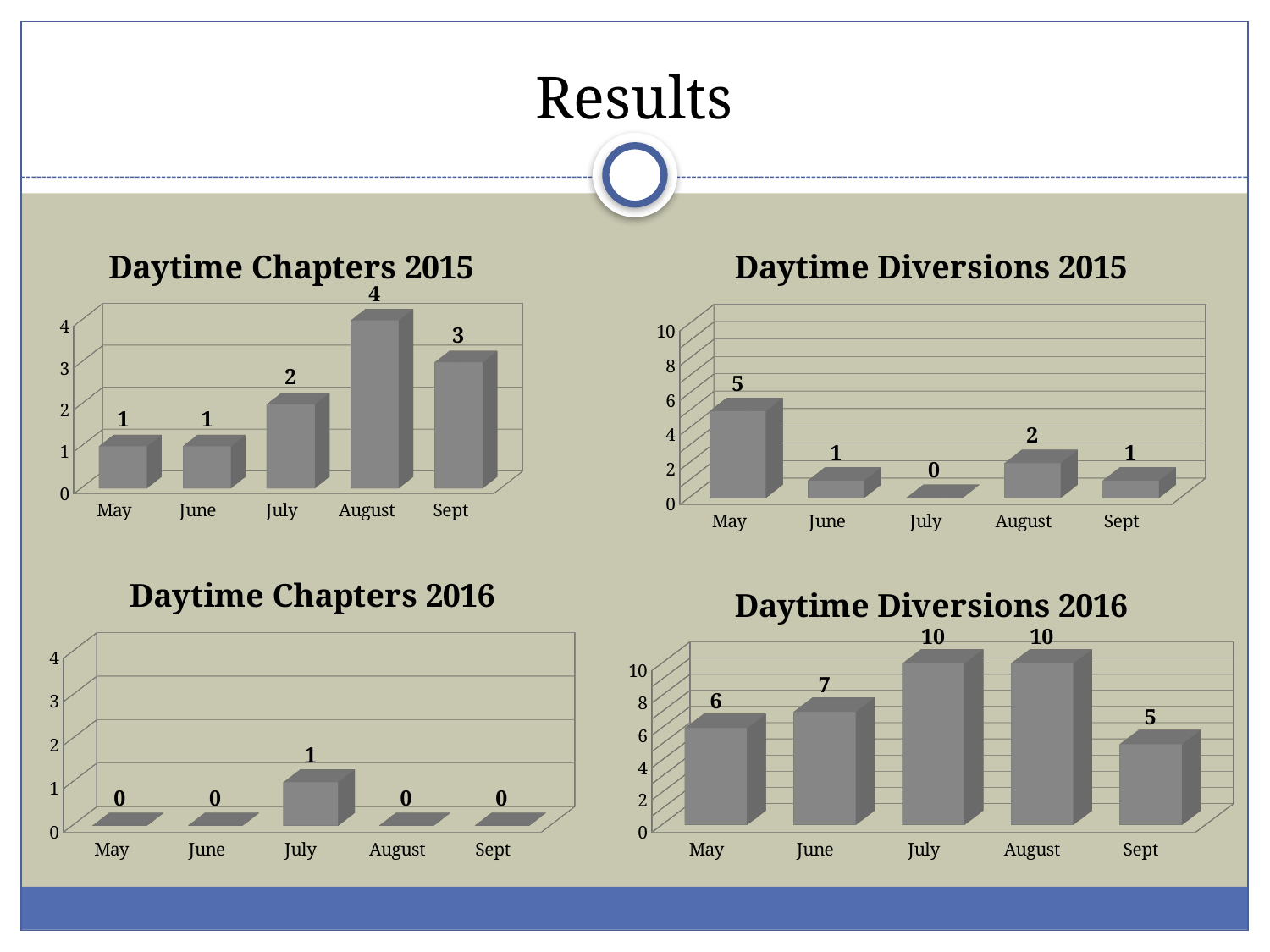
In the Daytime Diversions 2016 chart, what is the value for Sept? 5 What kind of chart is the Daytime Diversions 2016 chart? Bar chart In the Daytime Chapters 2015 chart, what is the value for August? 4 In the Daytime Diversions 2016 chart, which month has the lowest value? Sept In the Daytime Diversions 2015 chart, what is the value for July? 0 How many months are shown on the x axis of the Daytime Chapters 2016 chart? 5 In the Daytime Chapters 2016 chart, which month has the highest value? July In the Daytime Diversions 2016 chart, what is the difference between the values for July and May? 4 In the Daytime Chapters 2015 chart, do the values rise or fall from June to August? Rise In the Daytime Diversions 2015 chart, which month has the highest value? May In the Daytime Diversions 2015 chart, which is larger, the value for May or the value for August? May In the Daytime Chapters 2015 chart, what is the difference between the values for August and July? 2